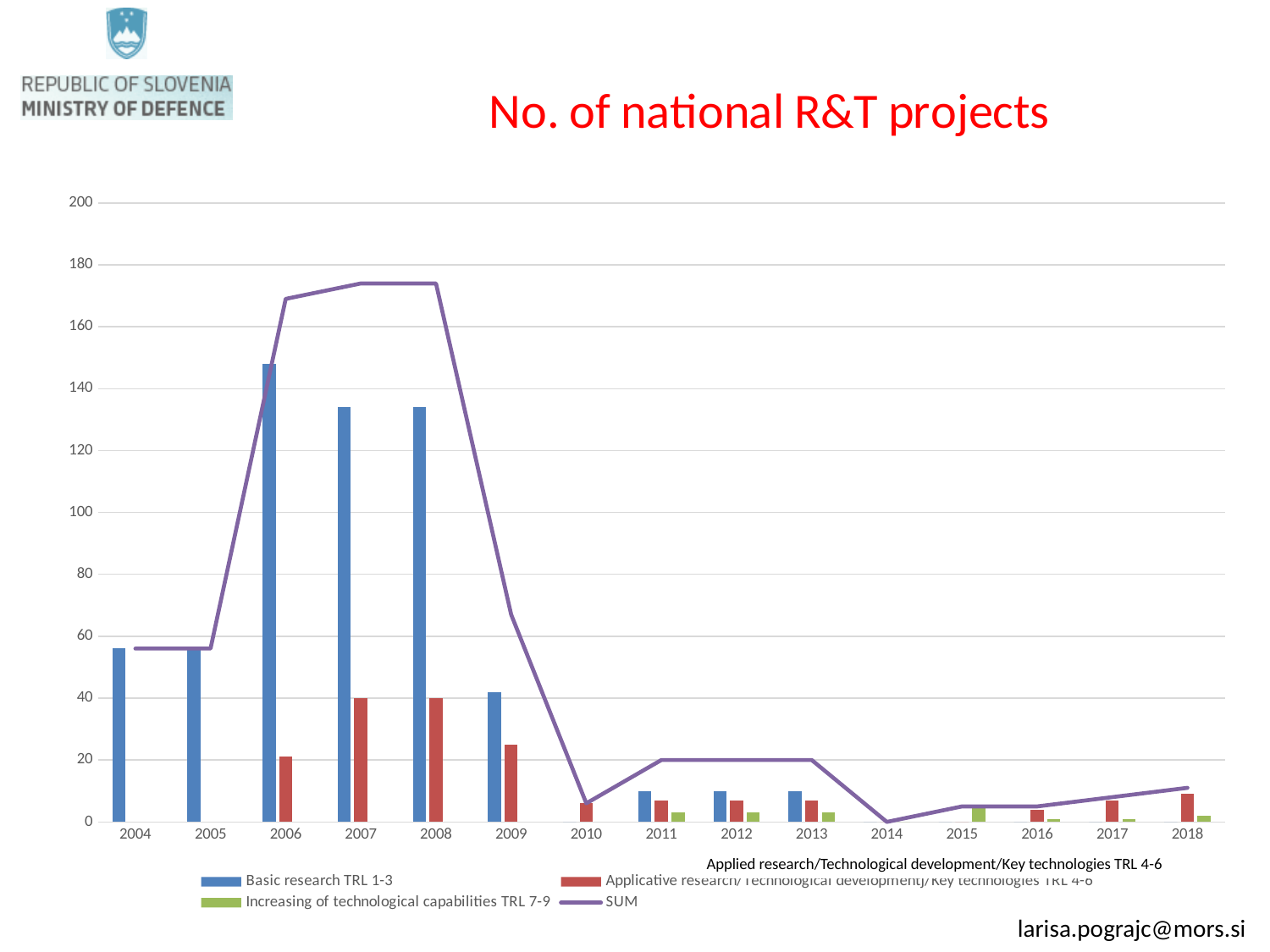
Which year has the larger Basic research TRL 1-3 value, 2004 or 2009? 2004 How many series does the legend list? 4 Is the SUM value for 2010 greater or less than 20? less Is the SUM value for 2006 greater or less than 160? greater In which year is the SUM line at its lowest? 2014 Does the SUM line rise or fall from 2008 to 2010? fall Is the Basic research TRL 1-3 value for 2006 greater or less than 140? greater What is the title of the chart? No. of national R&T projects What kind of chart is this? Bar chart with a line series How many years are shown on the x axis? 15 In which year is the Basic research TRL 1-3 value highest? 2006